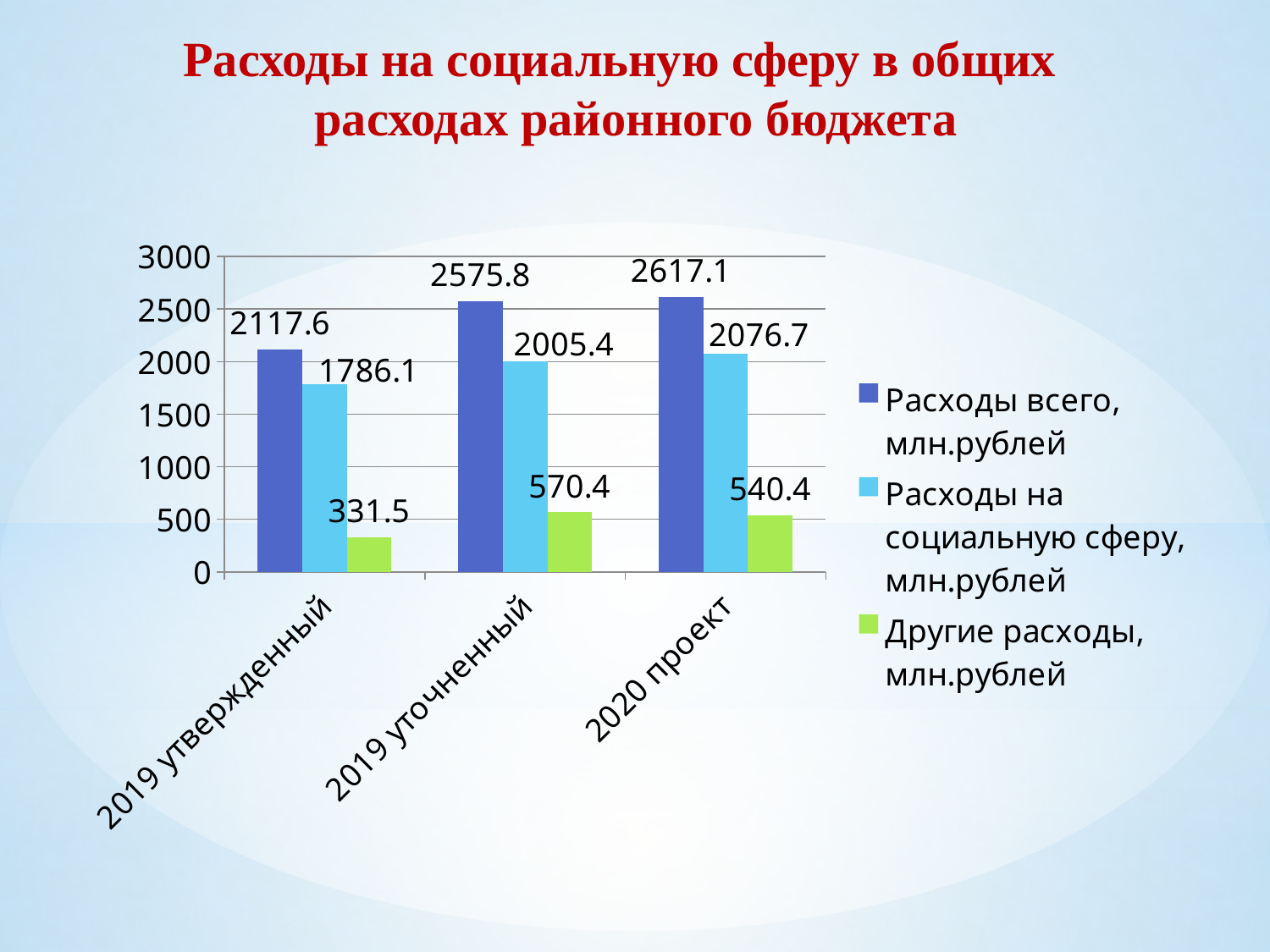
What is the value of "Расходы всего, млн.рублей" for "2019 утвержденный"? 2117.6 What is the value of "Другие расходы, млн.рублей" for "2019 уточненный"? 570.4 How many categories are shown on the x axis? 3 What is the difference between "Другие расходы, млн.рублей" for "2019 уточненный" and for "2020 проект"? 30 What is the difference between "Расходы на социальную сферу, млн.рублей" for "2020 проект" and for "2019 уточненный"? 71.3 Which is larger: "Другие расходы, млн.рублей" for "2019 уточненный" or for "2020 проект"? 2019 уточненный Which category has the lowest value for "Другие расходы, млн.рублей"? 2019 утвержденный What kind of chart is shown on the slide? bar chart What is the value of "Расходы на социальную сферу, млн.рублей" for "2020 проект"? 2076.7 Which category has the highest value for "Расходы всего, млн.рублей"? 2020 проект How many series does the legend list? 3 Is the value of "Расходы на социальную сферу, млн.рублей" for "2019 утвержденный" greater or less than 2000? less